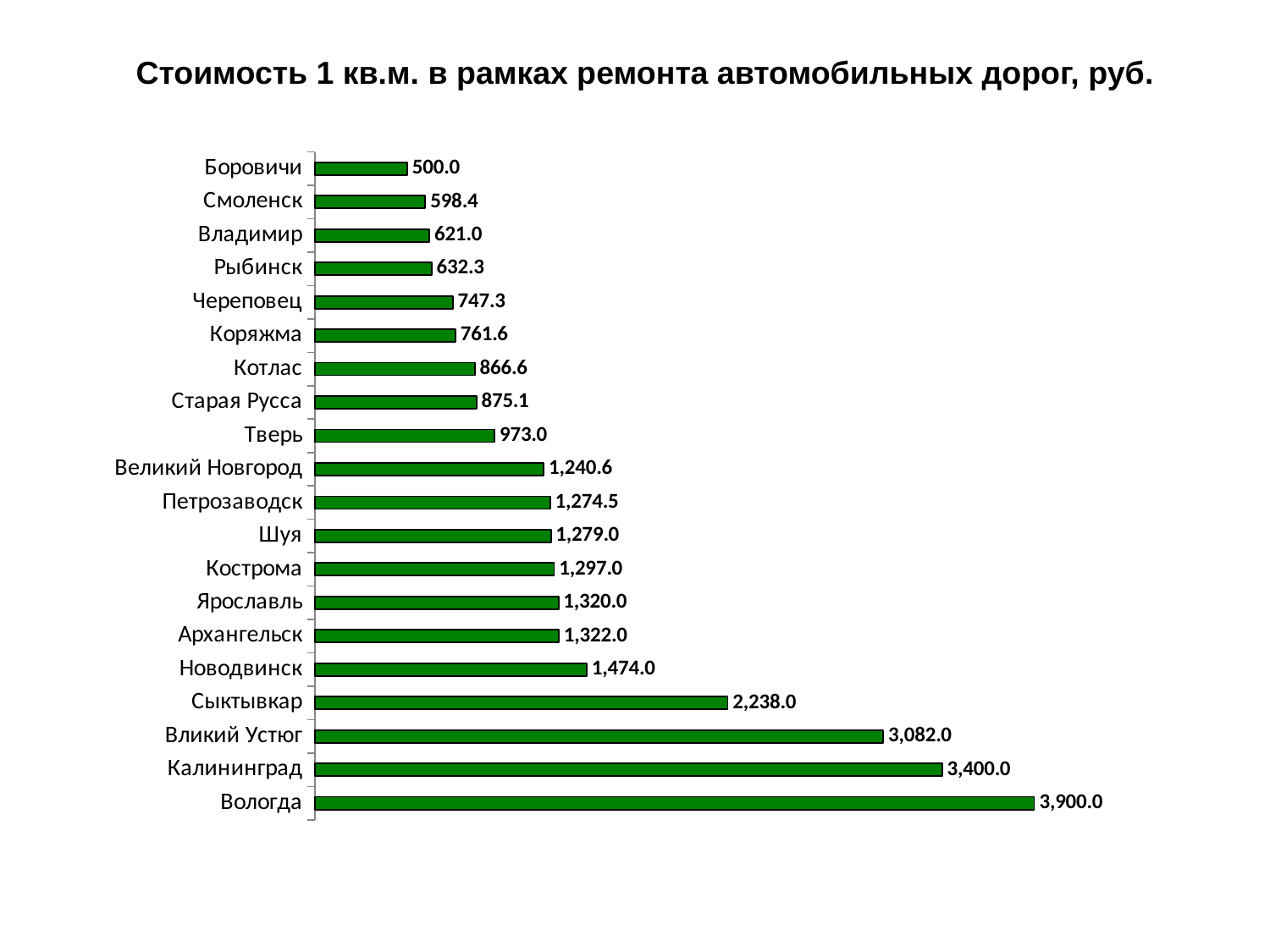
What is the value for Петрозаводск? 1,274.5 What is the value for Череповец? 747.3 Which is larger, the value for Вликий Устюг or the value for Сыктывкар? Вликий Устюг What is the title of the chart? Стоимость 1 кв.м. в рамках ремонта автомобильных дорог, руб. What is the difference between the values for Сыктывкар and Новодвинск? 764.0 What is the value for Сыктывкар? 2,238.0 What is the value for Вологда? 3,900.0 Which city has the highest value? Вологда What is the difference between the values for Вологда and Калининград? 500.0 How many cities are shown in the chart? 20 What kind of chart is shown on the slide? Bar chart Which city has the lowest value? Боровичи